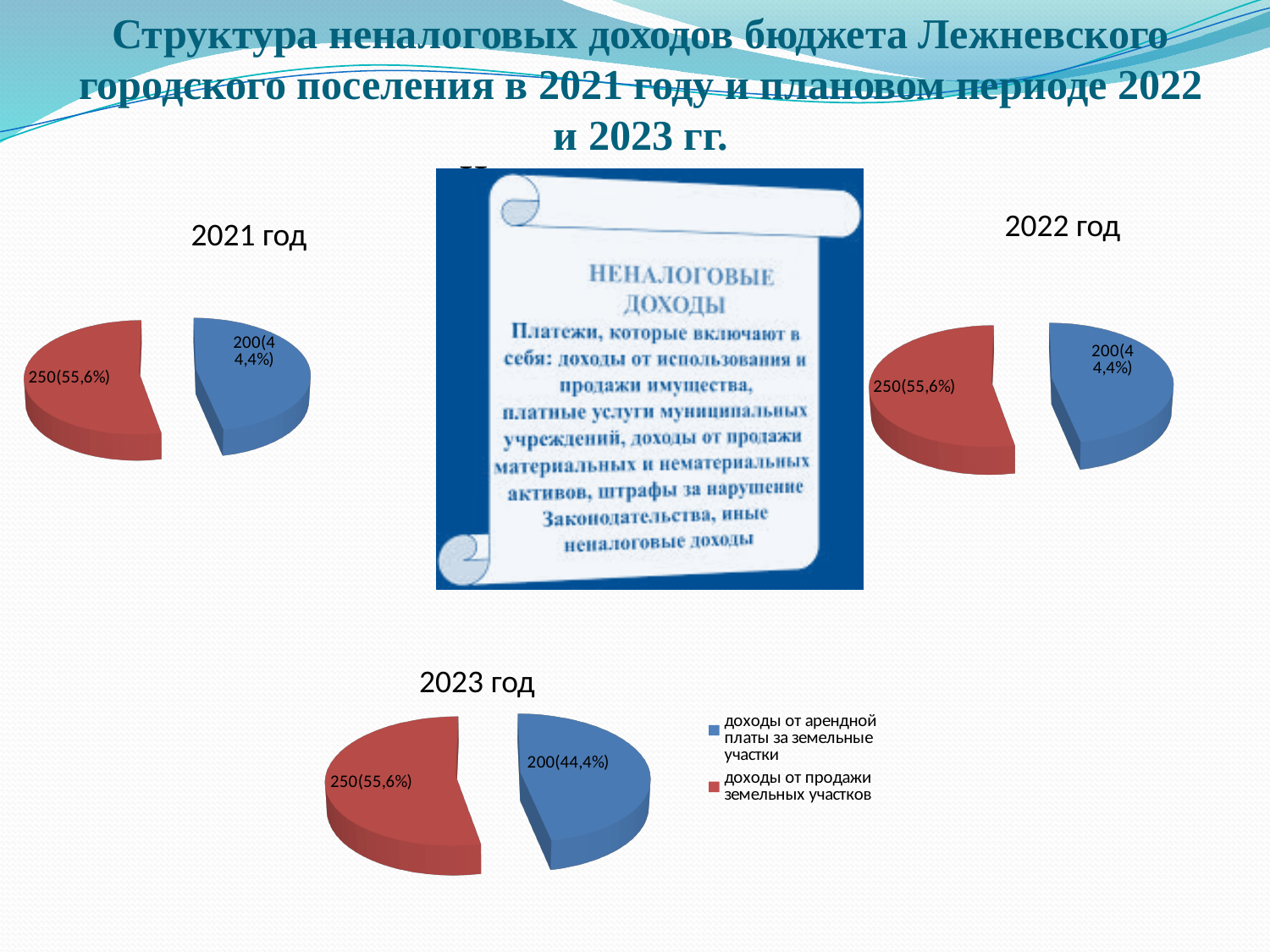
In the 2023 год chart, what value is shown for доходы от арендной платы за земельные участки? 200(44,4%) In the 2023 год chart, which category has the smallest slice? доходы от арендной платы за земельные участки In the 2023 год chart, what is the difference between the value for доходы от продажи земельных участков and the value for доходы от арендной платы за земельные участки? 50 What type of chart is used for the 2021 год chart? pie chart How many entries does the legend next to the 2023 год chart list? 2 In the 2023 год chart, which category has the largest slice? доходы от продажи земельных участков How many slices does the 2022 год pie chart have? 2 How many pie charts are shown on the slide? 3 In the 2023 год chart, what value is shown for доходы от продажи земельных участков? 250(55,6%) In the 2021 год chart, what is the value of the red slice? 250(55,6%) In the 2023 год chart, what share of the pie does доходы от арендной платы за земельные участки represent? 44,4% In the 2022 год chart, what is the value of the blue slice? 200(44,4%)